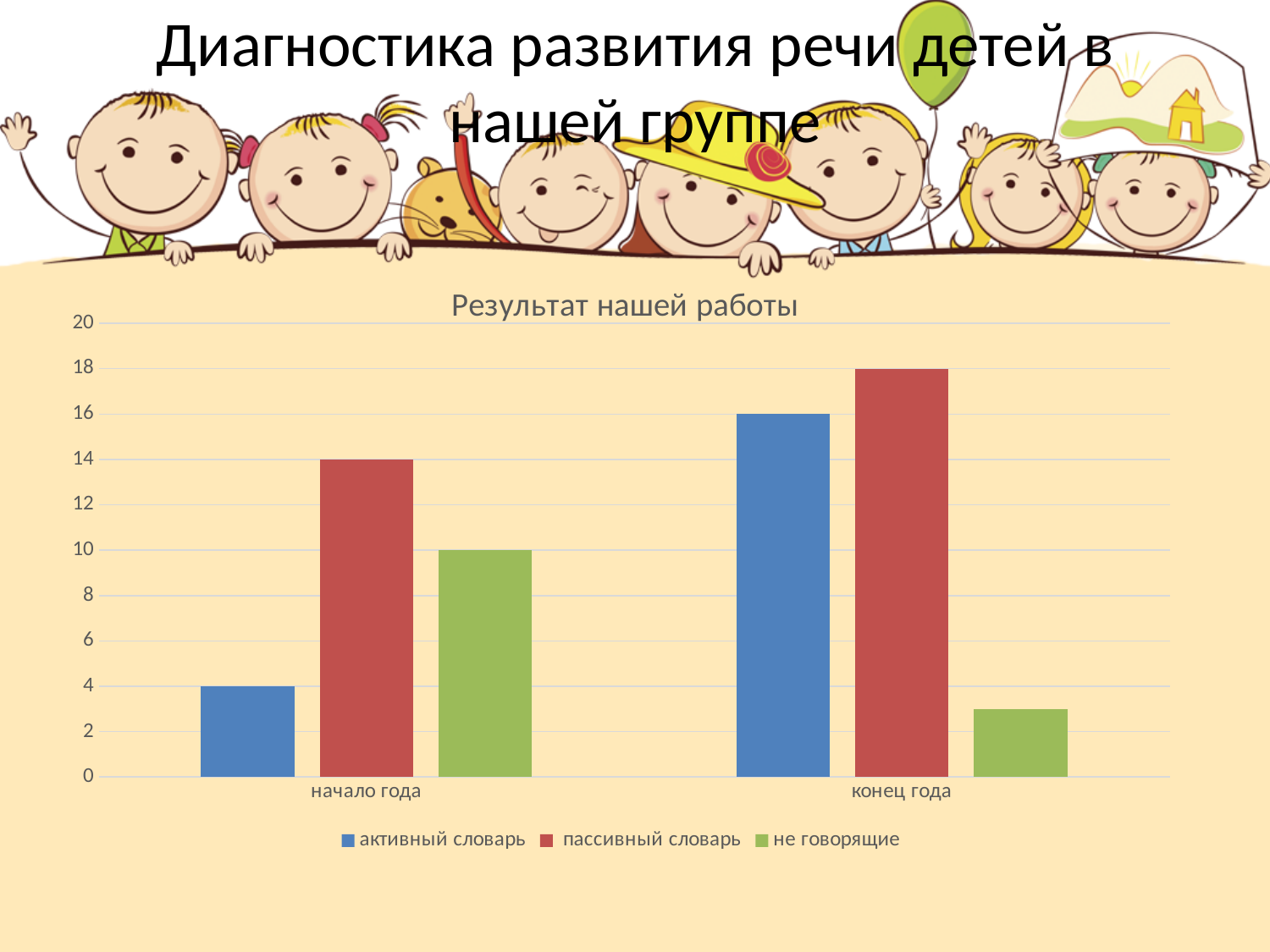
Which series has the highest value at конец года? пассивный словарь What is the value for пассивный словарь at конец года? 18 What is the difference between активный словарь at конец года and at начало года? 12 What is the value for не говорящие at начало года? 10 What is the title of the chart? Результат нашей работы Which series has the lowest value at начало года? активный словарь How many categories are shown on the x axis? 2 Does the value for не говорящие rise or fall from начало года to конец года? fall What is the value for активный словарь at начало года? 4 How many series does the legend list? 3 What type of chart is shown on the slide? bar chart Is the value for не говорящие at конец года greater or less than 4? less